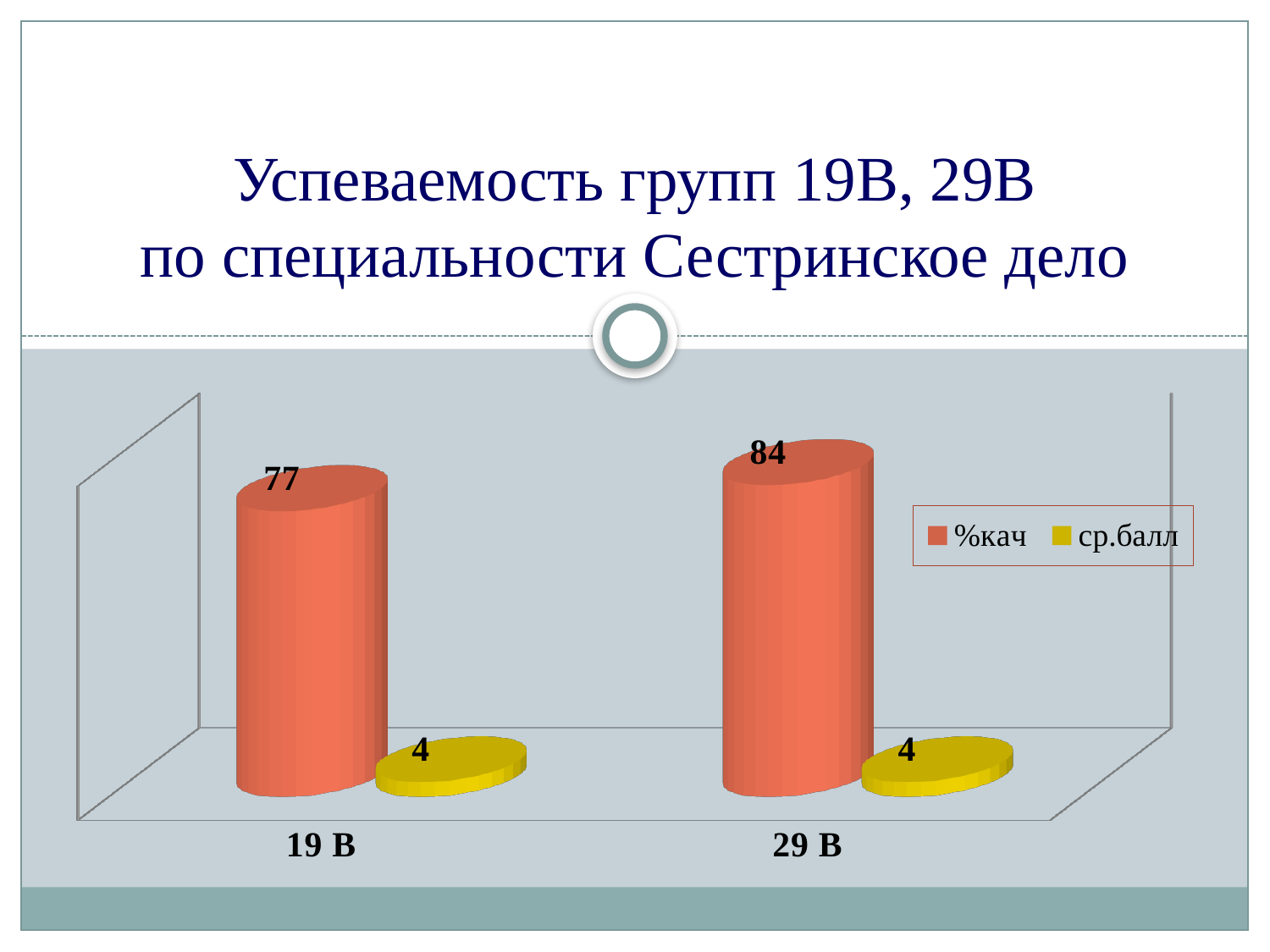
What is the ср.балл value for group 29 В? 4 What is the ср.балл value for group 19 В? 4 Which colour represents the ср.балл series in the legend? yellow Is the %кач value for 19 В larger or smaller than the %кач value for 29 В? smaller Which group has the higher %кач value? 29 В What kind of chart is shown on the slide? bar chart How many groups (categories) are shown on the x axis? 2 What is the %кач value for group 29 В? 84 What is the %кач value for group 19 В? 77 How many series does the legend list? 2 Which group has the lower %кач value? 19 В What is the difference in %кач between group 29 В and group 19 В? 7